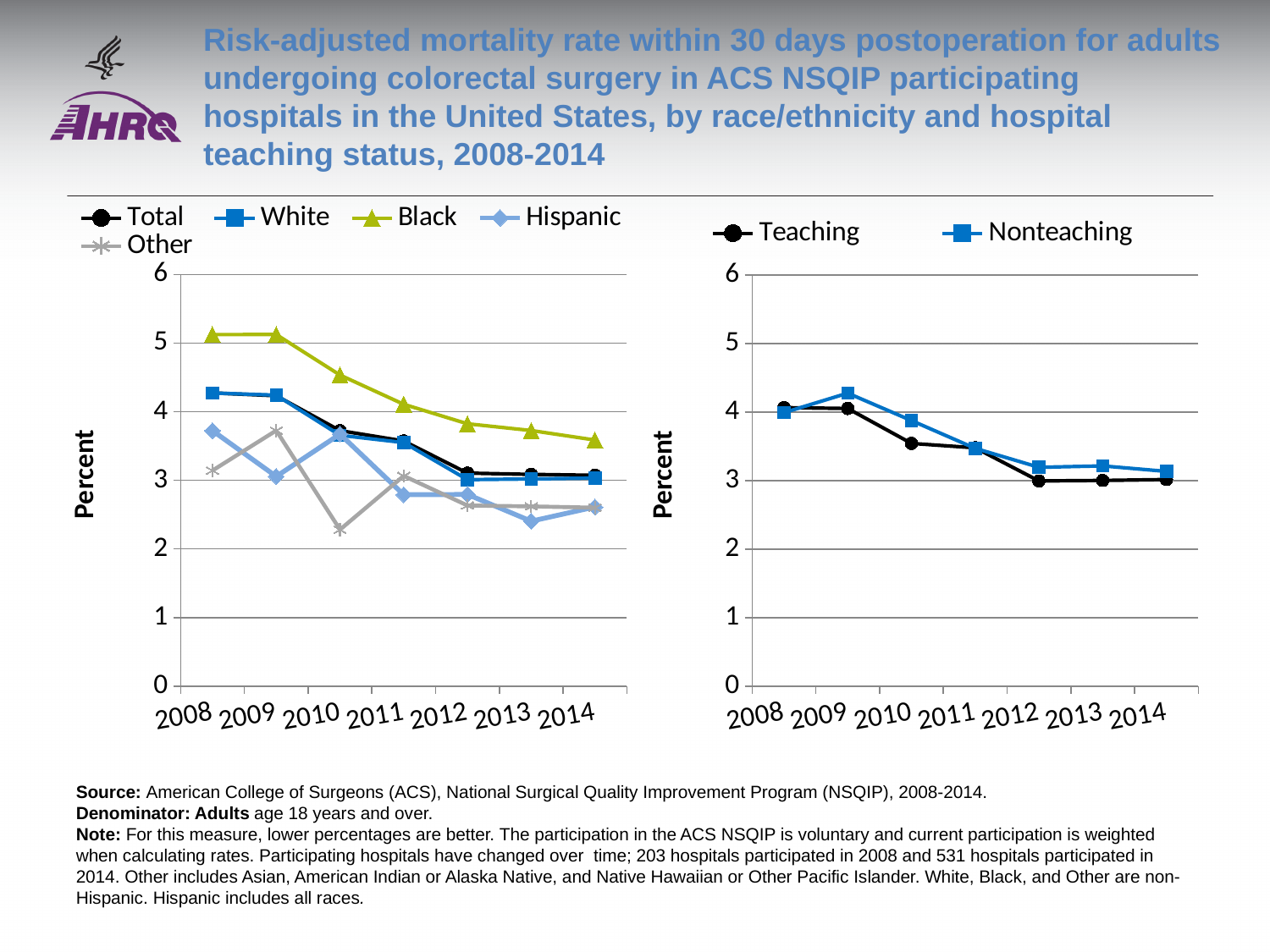
In the left chart (by race/ethnicity), which series has the lowest value in 2010? Other How many series does the legend of the left chart (by race/ethnicity) list? 5 In the left chart (by race/ethnicity), is the value for Hispanic in 2013 greater or less than 3? less How many series does the legend of the right chart (by hospital teaching status) list? 2 In the left chart (by race/ethnicity), which series has the highest value in 2008? Black What kind of chart is the left chart (by race/ethnicity)? Line chart How many years are plotted along the x axis of the right chart (by hospital teaching status)? 7 In the left chart (by race/ethnicity), is the value for Black in 2008 greater or less than 5? greater In the right chart (by hospital teaching status), does the Teaching series generally rise or fall from 2008 to 2014? Fall In the right chart (by hospital teaching status), is the value for Nonteaching in 2009 greater or less than 4? greater In the right chart (by hospital teaching status), which is larger in 2010: Teaching or Nonteaching? Nonteaching In the left chart (by race/ethnicity), which is larger in 2009: Hispanic or Other? Other